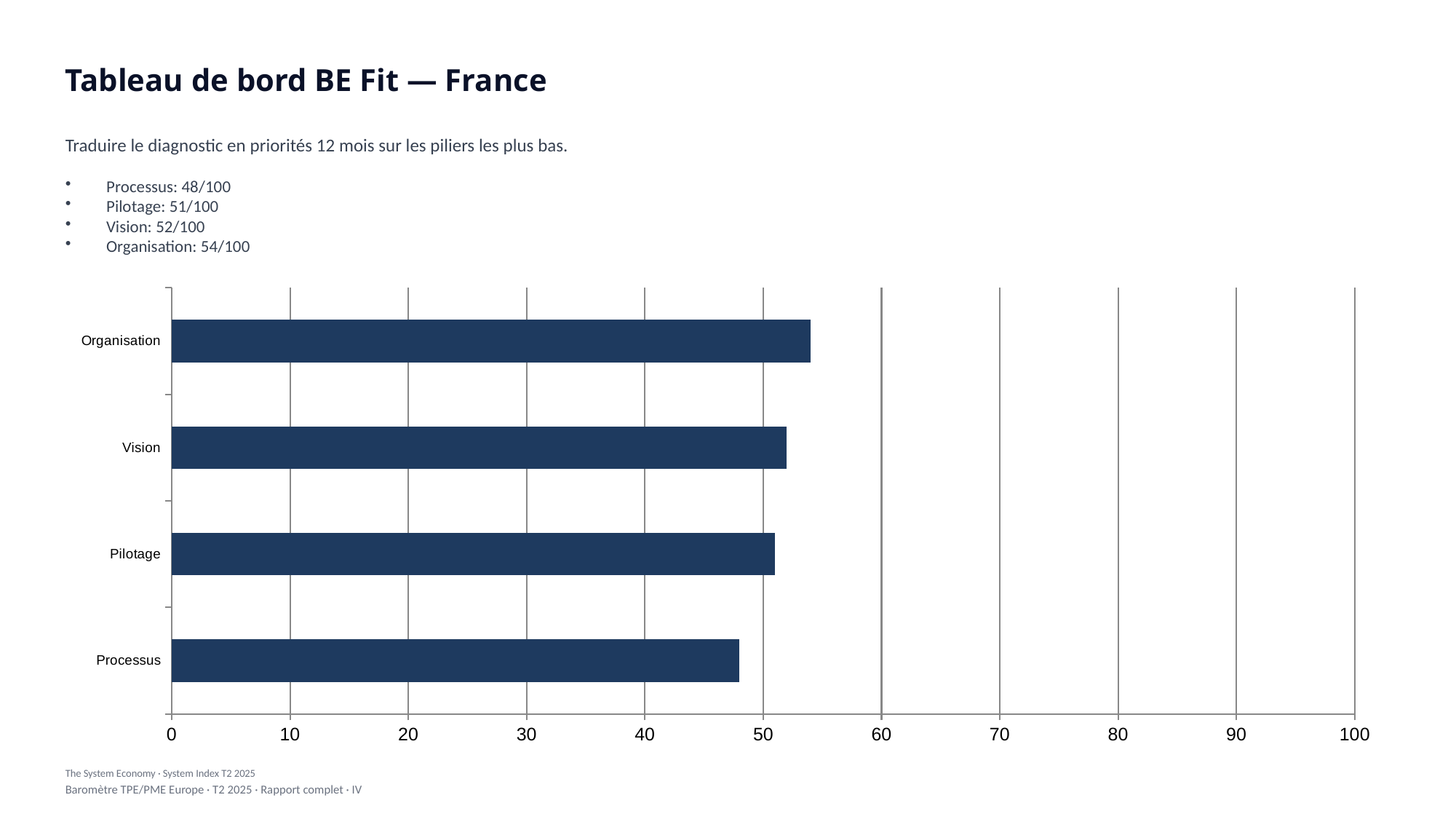
Which is larger, the value for Vision or the value for Pilotage? Vision What is the difference between the values for Organisation and Processus? 6 What kind of chart is shown on the slide? bar chart What is the value for Processus? 48/100 How many categories are shown in the chart? 4 Which category has the highest value? Organisation What is the value for Pilotage? 51/100 What is the title of the slide? Tableau de bord BE Fit — France Which category has the lowest value? Processus What is the value for Vision? 52/100 Is the value for Processus greater or less than 50? less What is the value for Organisation? 54/100